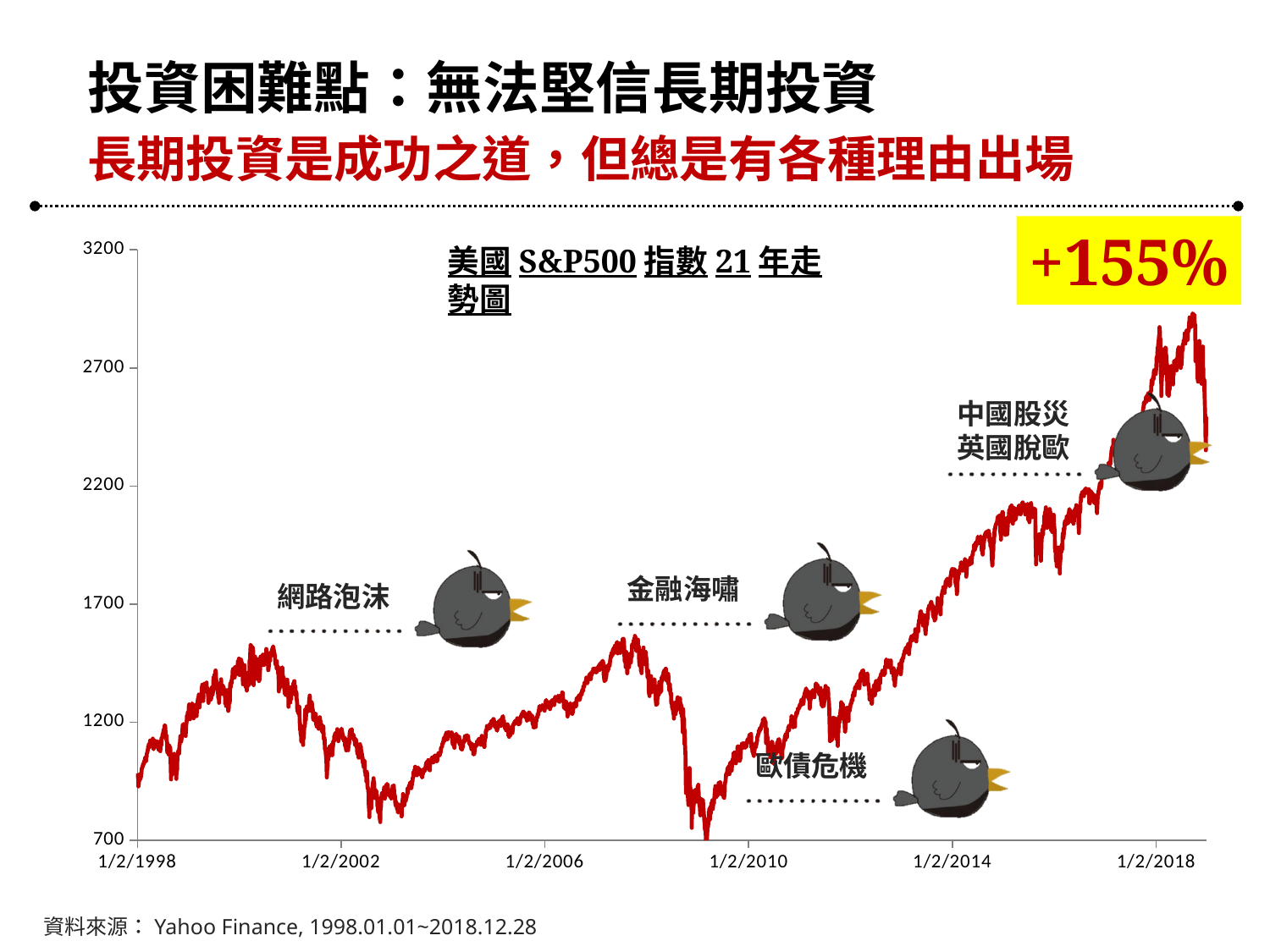
Is the value of the index at 1/2/1998 greater or less than 1200? less What percentage gain is highlighted in the yellow box on the chart? +155% How many crisis events are annotated with labels on the chart? 5 Is the value of the index at 1/2/2010 greater or less than 1700? less What kind of chart is shown on the slide? line chart What is the title of the chart? 美國 S&P500 指數 21 年走勢圖 Is the value of the index at 1/2/2018 greater or less than 2200? greater Overall, does the index rise or fall from 1998 to 2018? rise How many date labels are shown on the x axis? 6 What is the highest value shown on the y axis? 3200 Which is larger, the index value at 1/2/1998 or at 1/2/2018? 1/2/2018